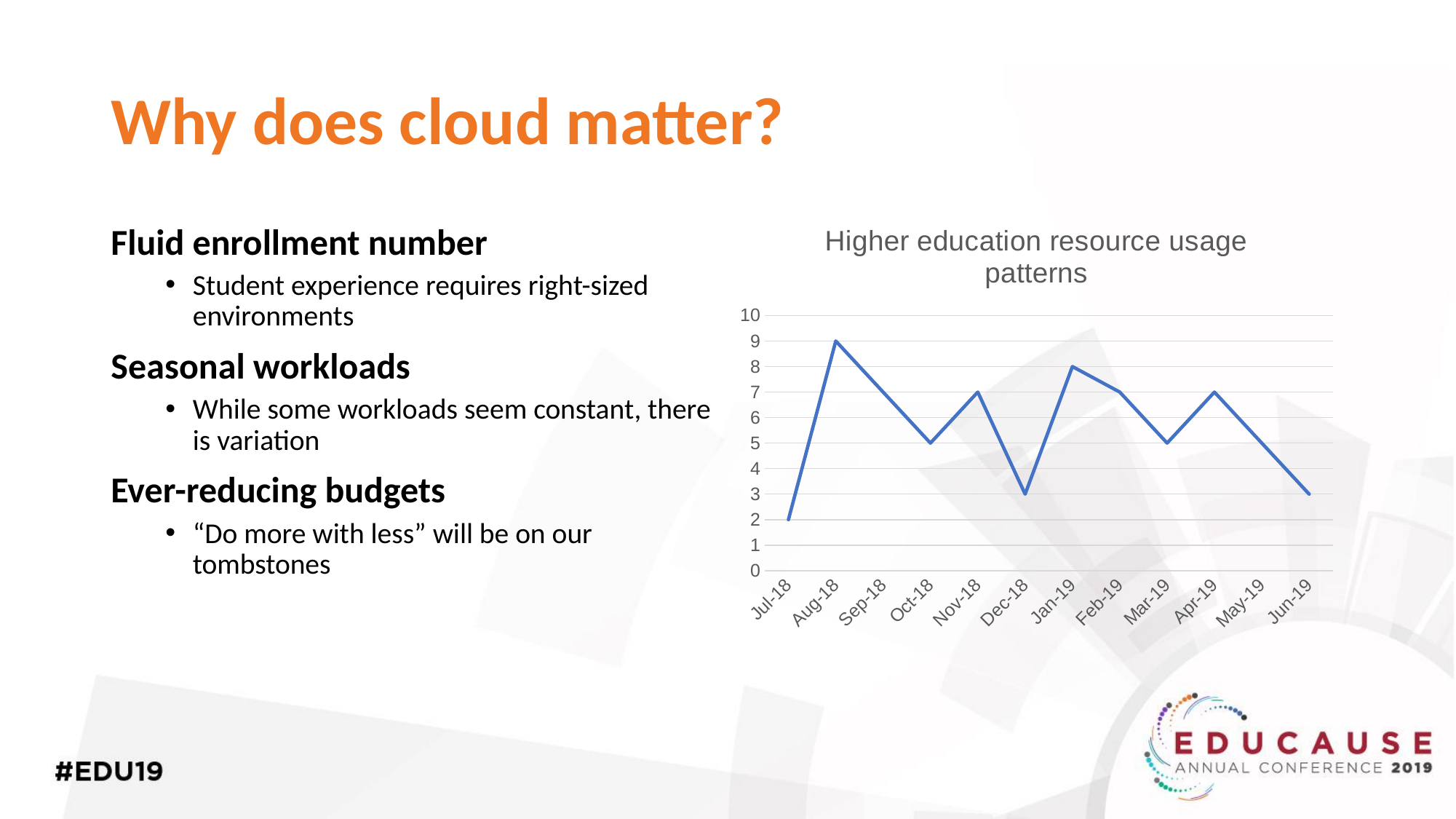
Does the value rise or fall from Apr-19 to Jun-19? fall What is the value for Aug-18? 9 How many months are plotted on the x axis of the chart? 12 What is the difference between the values for Aug-18 and Jul-18? 7 Which month has the lowest value in the chart? Jul-18 What is the value for Dec-18? 3 Which month has the highest value in the chart? Aug-18 Is the value for Oct-18 greater or less than 8? less What is the title of the chart? Higher education resource usage patterns What is the value for Jan-19? 8 What type of chart is shown on the slide? line chart Which is larger, the value for Jan-19 or the value for Mar-19? Jan-19